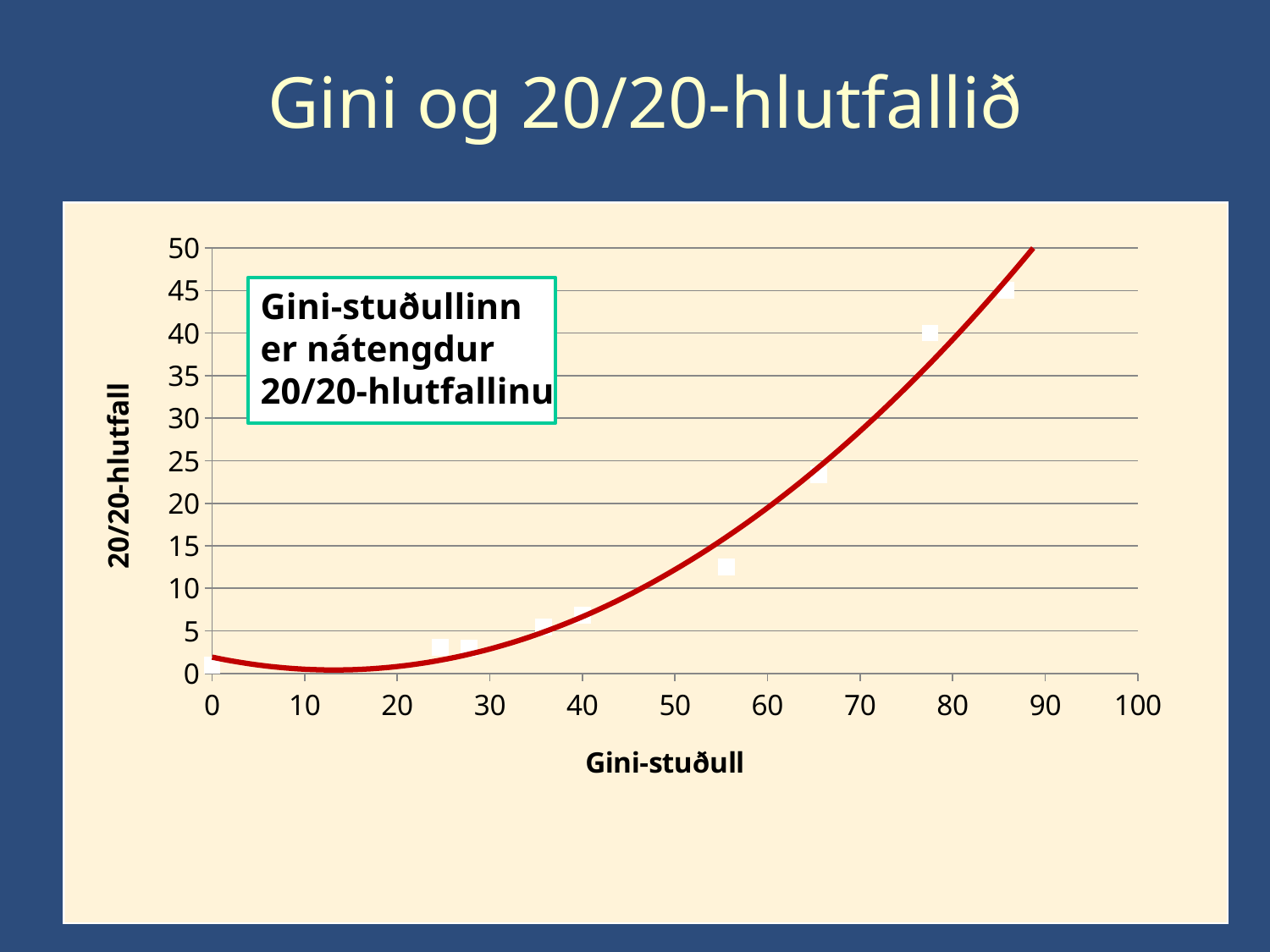
What is the title of the chart on the slide? Gini og 20/20-hlutfallið Is the 20/20-hlutfall for the data point near Gini-stuðull 24 greater or less than 5? less What is the highest value shown on the vertical axis? 50 Is the 20/20-hlutfall for the data point near Gini-stuðull 77 greater or less than 35? greater What kind of chart is shown on the slide? Scatter chart with a trend line What is the label of the horizontal axis? Gini-stuðull Which data point has the highest 20/20-hlutfall on the chart? The point near Gini-stuðull 86 Is the 20/20-hlutfall for the data point near Gini-stuðull 55 greater or less than 15? less Do the 20/20-hlutfall values generally rise or fall as the Gini-stuðull increases? Rise Which data point has the higher 20/20-hlutfall: the one near Gini-stuðull 55 or the one near Gini-stuðull 77? The one near Gini-stuðull 77